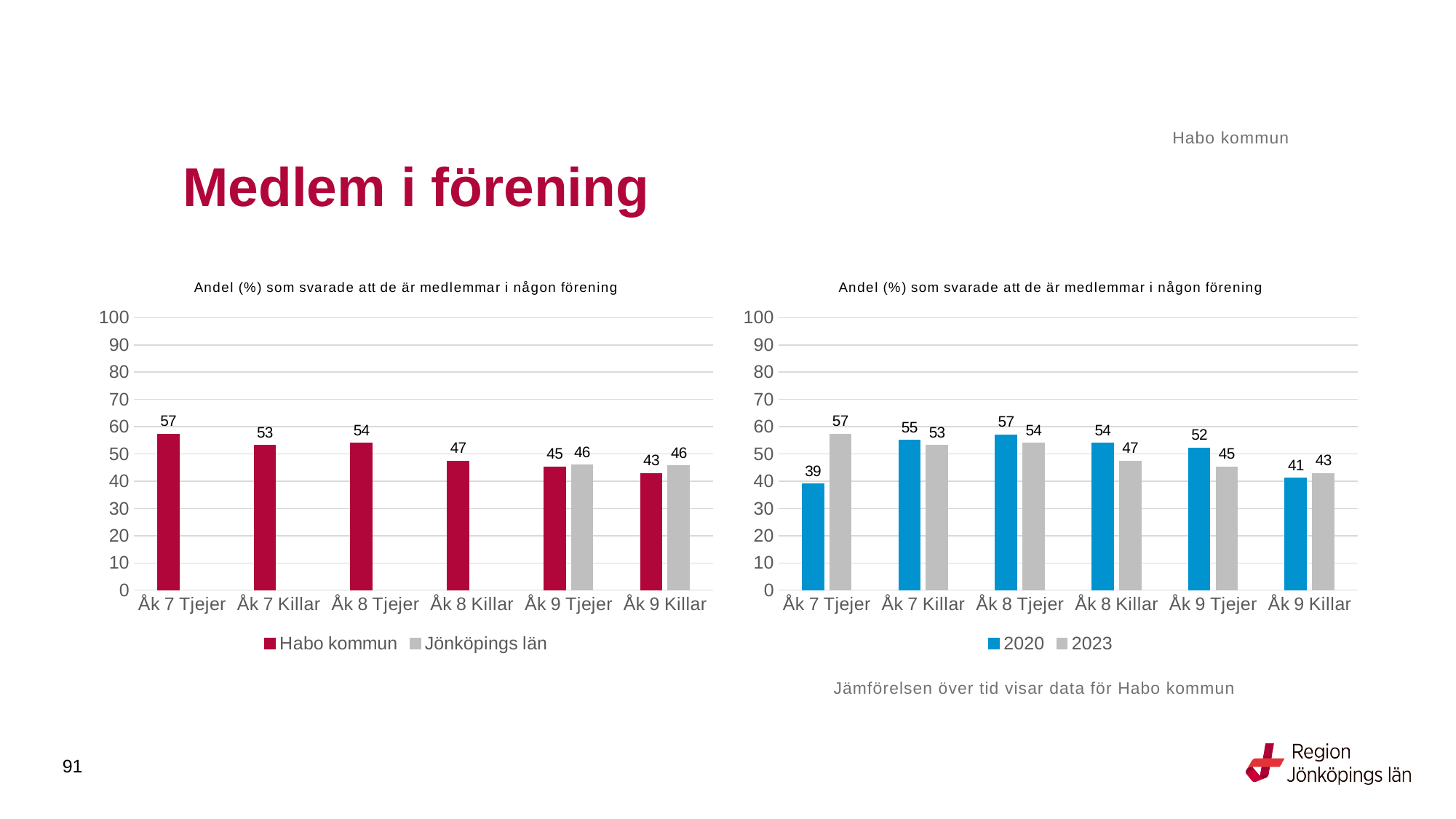
In the right chart, what is the difference between the 2020 and 2023 values for Åk 7 Tjejer? 18 In the right chart, which category has the lowest 2020 value? Åk 7 Tjejer In the left chart, how many series does the legend list? 2 How many categories are shown on the x axis of the right chart? 6 In the left chart, which category has the lowest Habo kommun value? Åk 9 Killar What type of chart is the left chart? Bar chart In the left chart, what is the difference between the Habo kommun values for Åk 7 Tjejer and Åk 9 Killar? 14 In the left chart, what is the value for Jönköpings län for Åk 9 Killar? 46 In the right chart, which is larger for Åk 9 Tjejer, the 2020 value or the 2023 value? 2020 In the right chart, what is the 2020 value for Åk 7 Tjejer? 39 In the right chart, what is the 2023 value for Åk 8 Killar? 47 In the left chart, what is the value for Habo kommun for Åk 7 Tjejer? 57